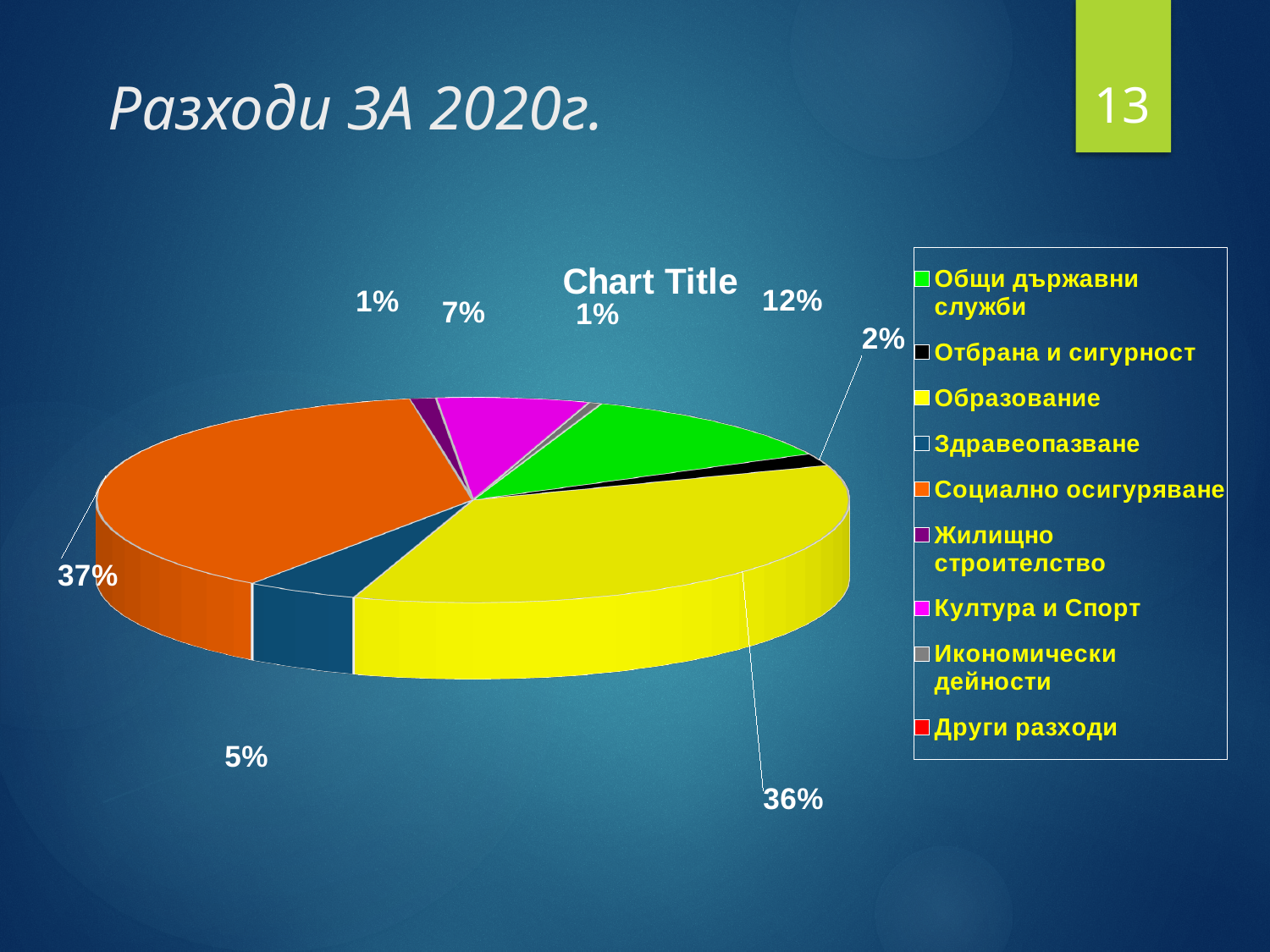
What share of the pie does Социално осигуряване have? 37% What share of the pie does Култура и Спорт have? 7% How many categories does the legend of the pie chart list? 9 What is the difference between the shares of Социално осигуряване and Образование? 1% Which category has the largest share of the pie? Социално осигуряване What is the title printed above the pie chart? Chart Title What colour is the slice for Социално осигуряване? orange Which has a larger share, Общи държавни служби or Култура и Спорт? Общи държавни служби What share of the pie does Отбрана и сигурност have? 2% What share of the pie does Образование have? 36% What kind of chart is shown on the slide? pie chart What share of the pie does Общи държавни служби have? 12%